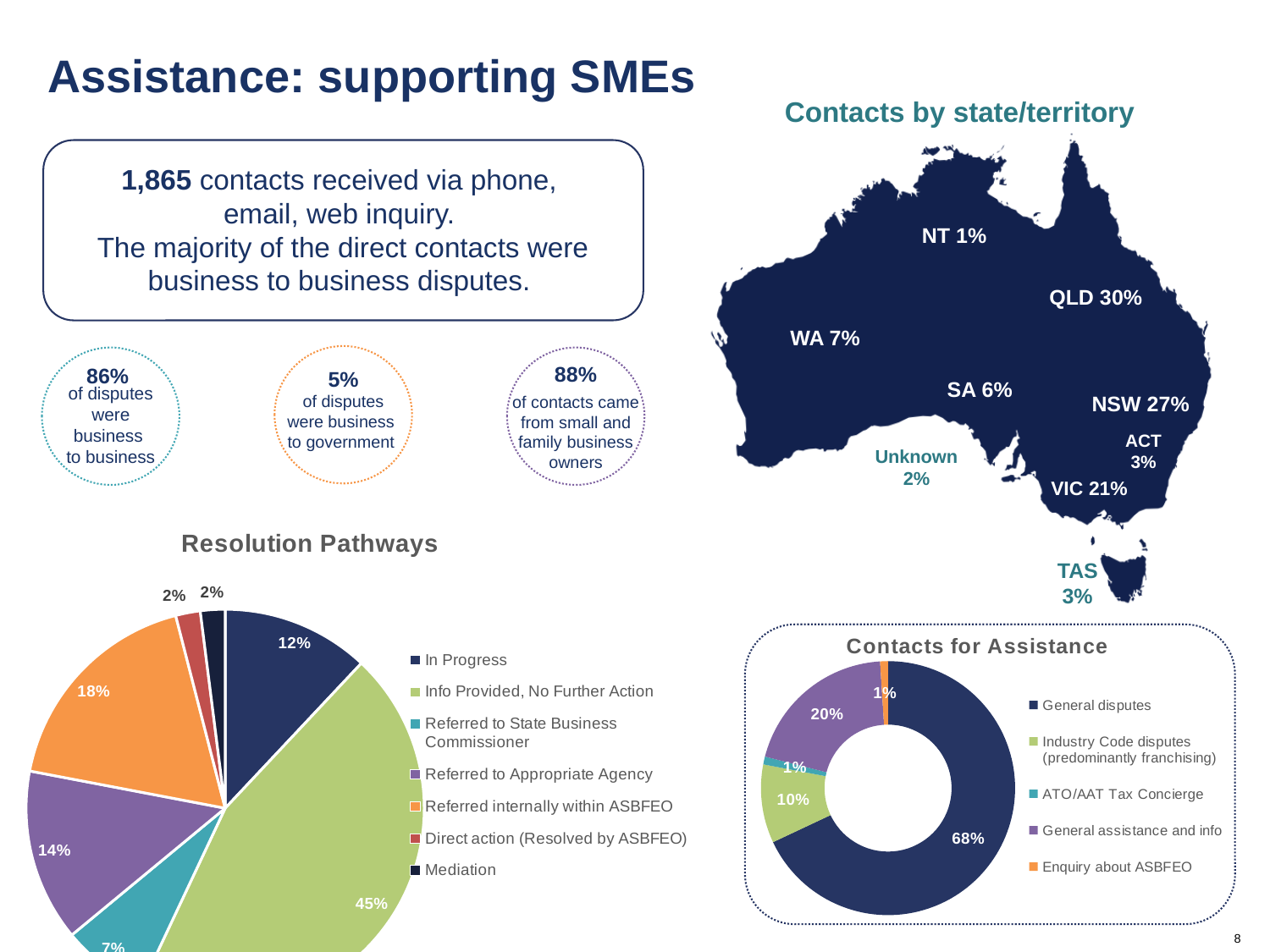
In the Contacts for Assistance chart, what percentage is General assistance and info? 20% In the Resolution Pathways chart, which category has the largest share? Info Provided, No Further Action In the Resolution Pathways chart, which is larger: Referred internally within ASBFEO or Referred to Appropriate Agency? Referred internally within ASBFEO How many categories does the legend of the Resolution Pathways chart list? 7 In the Resolution Pathways chart, what share of cases is Info Provided, No Further Action? 45% In the Resolution Pathways chart, what percentage is Referred internally within ASBFEO? 18% What type of chart is the Resolution Pathways chart? Pie chart How many categories does the legend of the Contacts for Assistance chart list? 5 In the Contacts for Assistance chart, what is the difference between General disputes and Industry Code disputes? 58% What colour represents General disputes in the Contacts for Assistance chart? Dark blue In the Contacts for Assistance chart, what percentage is General disputes? 68% In the Resolution Pathways chart, what is the difference between the In Progress share and the Referred to Appropriate Agency share? 2%